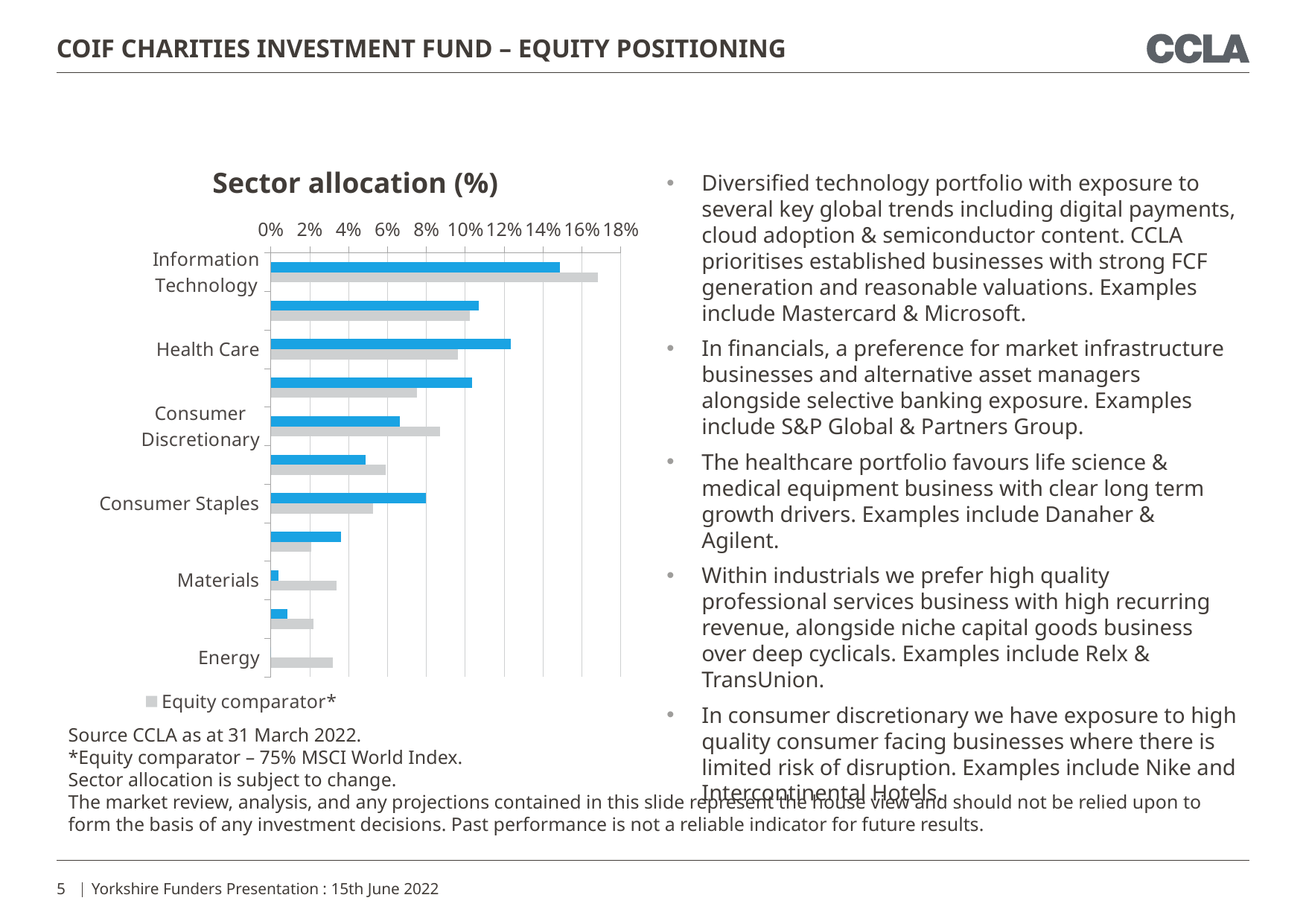
For Health Care, is the Equity comparator bar longer or shorter than the blue bar? shorter Is the Equity comparator value for Consumer Staples greater or less than 4%? greater Which has the larger Equity comparator value, Information Technology or Health Care? Information Technology Among the labelled sectors, which has the highest Equity comparator value? Information Technology Is the Equity comparator value for Consumer Discretionary greater or less than 10%? less How many sector labels are printed on the vertical axis of the chart? 6 Which series name is shown in the chart's legend? Equity comparator* Is the Equity comparator value for Health Care greater or less than 8%? greater What is the title of the chart on the slide? Sector allocation (%) What kind of chart is the Sector allocation (%) chart? Bar chart